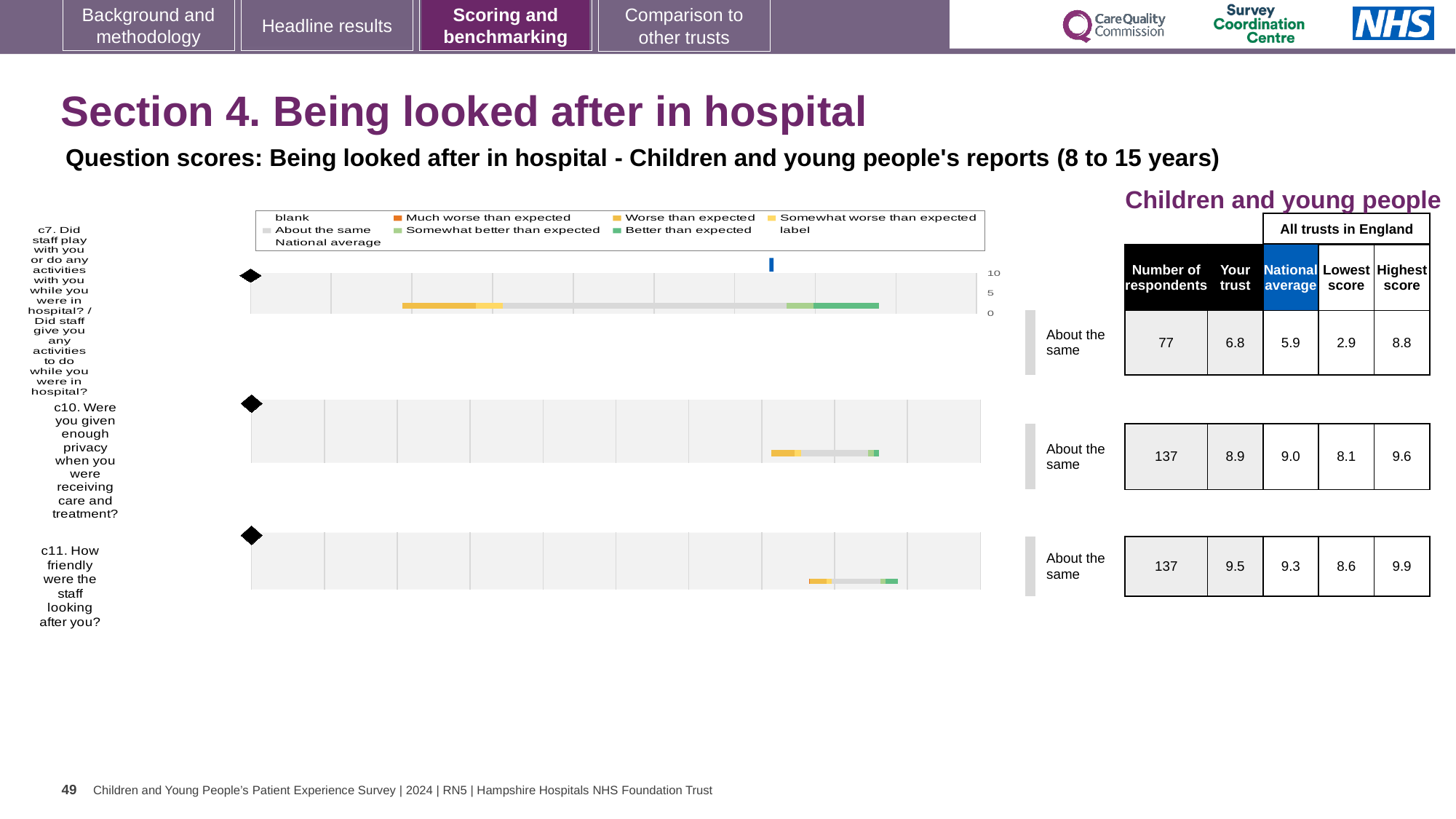
Is the 'Your trust' score for c7 greater or less than 5? greater What is the 'Your trust' score for c11 (How friendly were the staff looking after you?)? 9.5 Which question has the highest 'Your trust' score? c11. How friendly were the staff looking after you? What benchmark category is shown for c10 (Were you given enough privacy when you were receiving care and treatment?)? About the same What is the lowest score across all trusts in England for c11 (How friendly were the staff looking after you?)? 8.6 How many respondents answered c7 (Did staff play with you or do any activities with you while you were in hospital?)? 77 In the chart legend, which colour represents 'Better than expected'? Green For c7, which is larger: the 'Your trust' score or the national average? Your trust For c10 (Were you given enough privacy when you were receiving care and treatment?), what is the difference between the highest score and the lowest score across all trusts in England? 1.5 Which question has the lowest national average score? c7. Did staff play with you or do any activities with you while you were in hospital? What kind of chart is used to show the question scores on this slide? Bar chart How many questions (chart rows) are plotted on this slide? 3